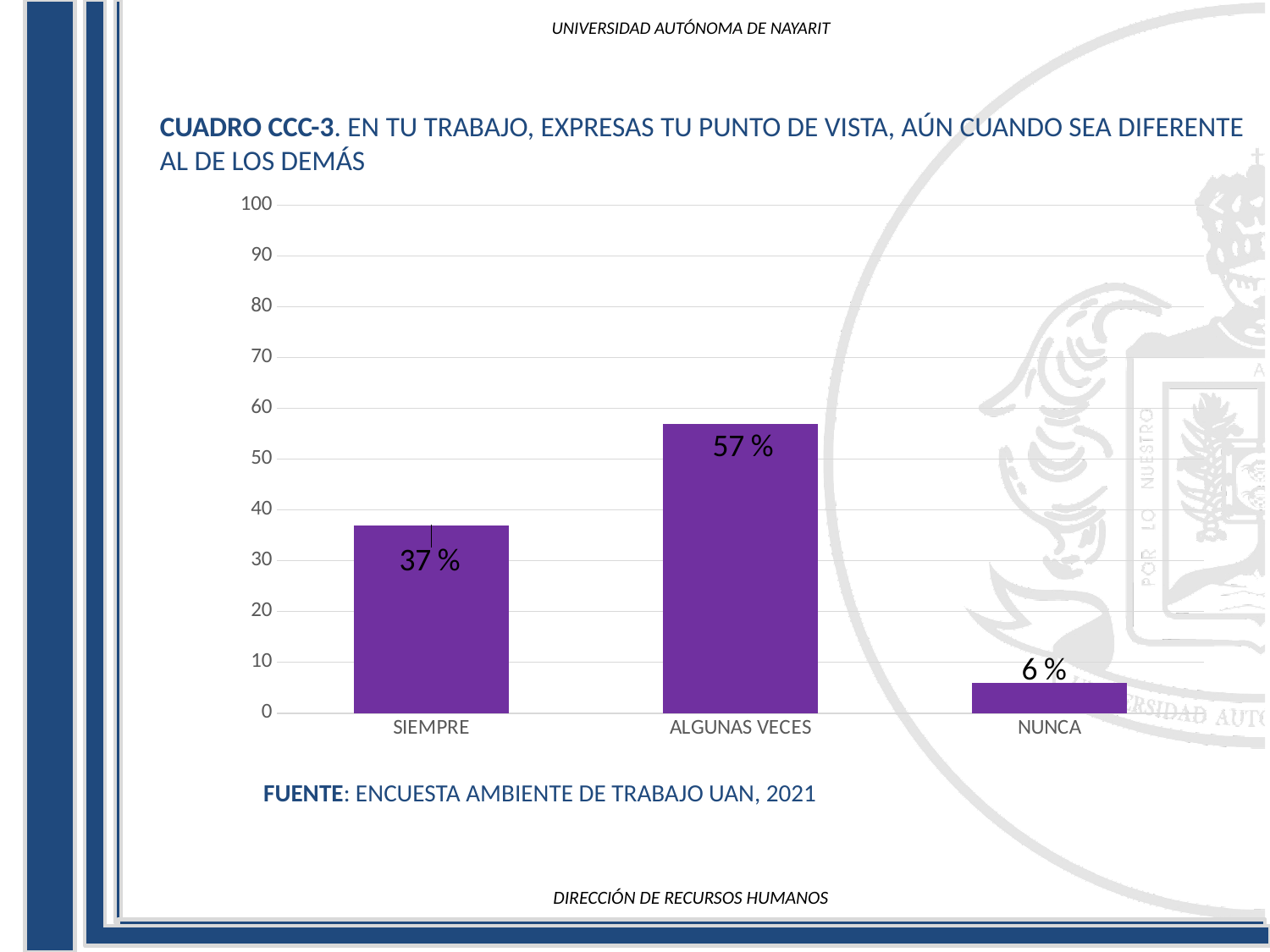
Is the value for ALGUNAS VECES greater or less than 50? greater What is the value for ALGUNAS VECES? 57 % Which category has the lowest value? NUNCA What is the value for SIEMPRE? 37 % What kind of chart is shown on the slide? bar chart What is the difference between the values for SIEMPRE and NUNCA? 31 % How many categories are shown on the x axis? 3 Which category has the highest value? ALGUNAS VECES What is the value for NUNCA? 6 % Which is larger, the value for SIEMPRE or the value for NUNCA? SIEMPRE What is the difference between the values for ALGUNAS VECES and SIEMPRE? 20 % What source is cited below the chart? ENCUESTA AMBIENTE DE TRABAJO UAN, 2021